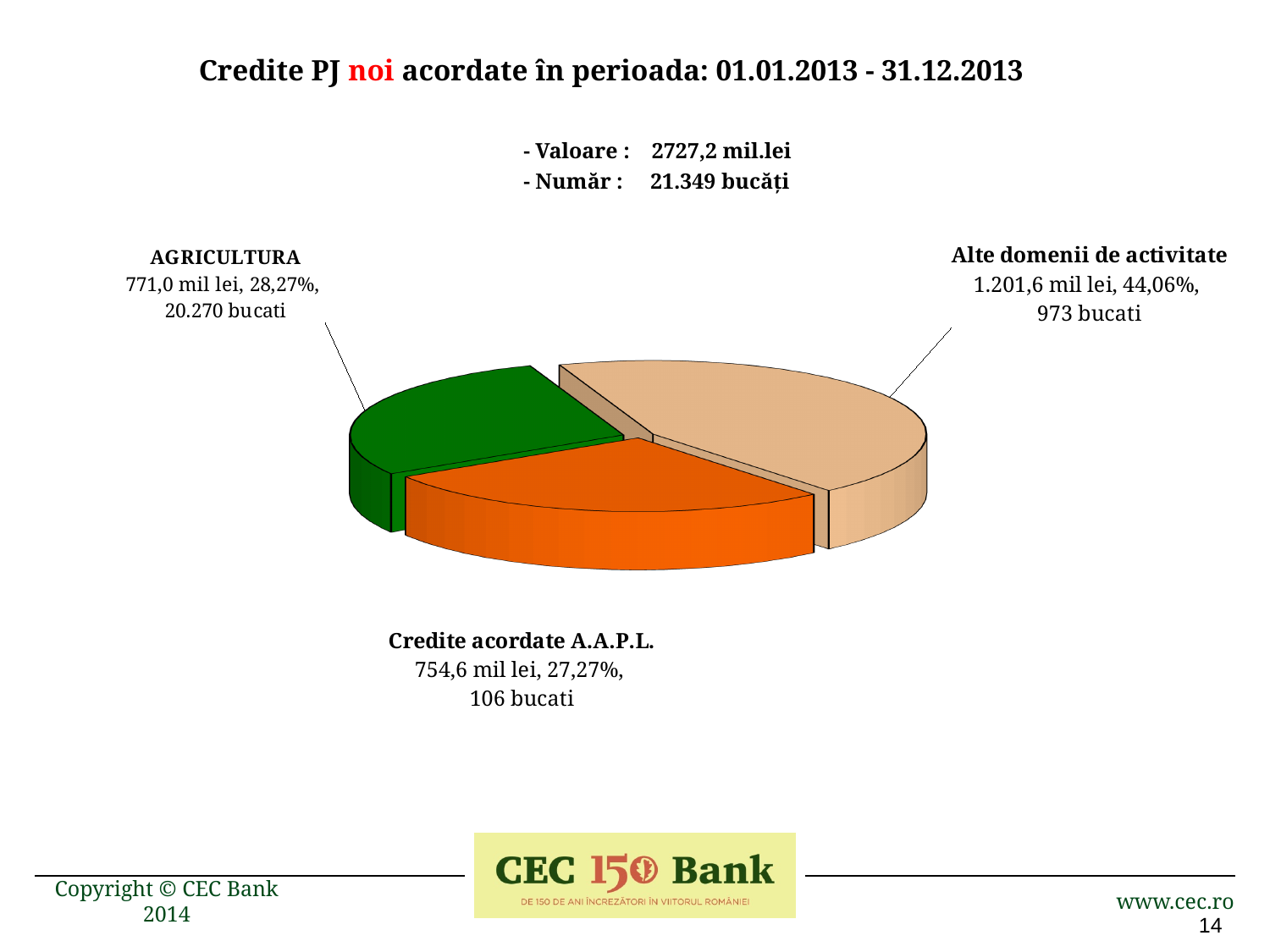
Which category has the smallest number of bucati? Credite acordate A.A.P.L. What kind of chart is shown on the slide? Pie chart How many slices does the pie chart have? 3 What colour is the AGRICULTURA slice? Green How many bucati are shown for Credite acordate A.A.P.L.? 106 bucati Which category has the largest value in mil lei? Alte domenii de activitate What percentage share does Alte domenii de activitate have? 44,06% What is the difference in mil lei between Alte domenii de activitate and AGRICULTURA? 430,6 mil lei What is the value in mil lei for AGRICULTURA? 771,0 mil lei What is the difference in bucati between AGRICULTURA and Alte domenii de activitate? 19.297 bucati Which has a larger value in mil lei, AGRICULTURA or Credite acordate A.A.P.L.? AGRICULTURA What is the total value (Valoare) stated on the slide? 2727,2 mil.lei